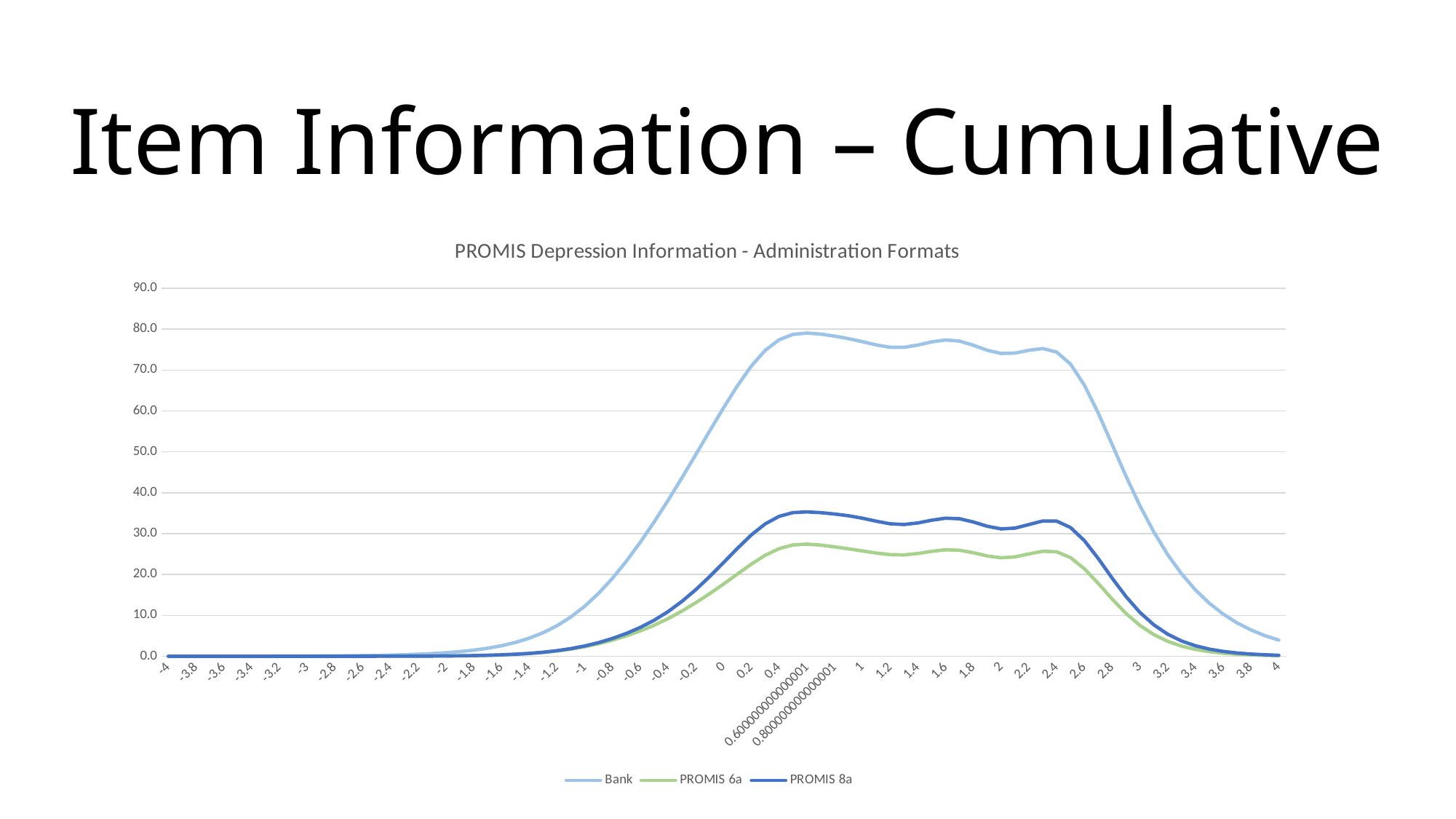
How many series does the legend list? 3 Does the Bank series rise or fall between x = 2.6 and x = 4? fall Which series reaches the highest value on the chart? Bank Which series are listed in the legend? Bank, PROMIS 6a, PROMIS 8a Is the value for PROMIS 6a at 0.4 greater or less than 30? less Is the value for Bank at 0 greater or less than 50? greater What kind of chart is shown on the slide? line chart At x = 2, which is larger: PROMIS 8a or PROMIS 6a? PROMIS 8a What is the title of the chart? PROMIS Depression Information - Administration Formats At x = 1, which is larger: Bank or PROMIS 8a? Bank Which series has the lowest peak value? PROMIS 6a Is the value for Bank at 0.4 greater or less than 70? greater